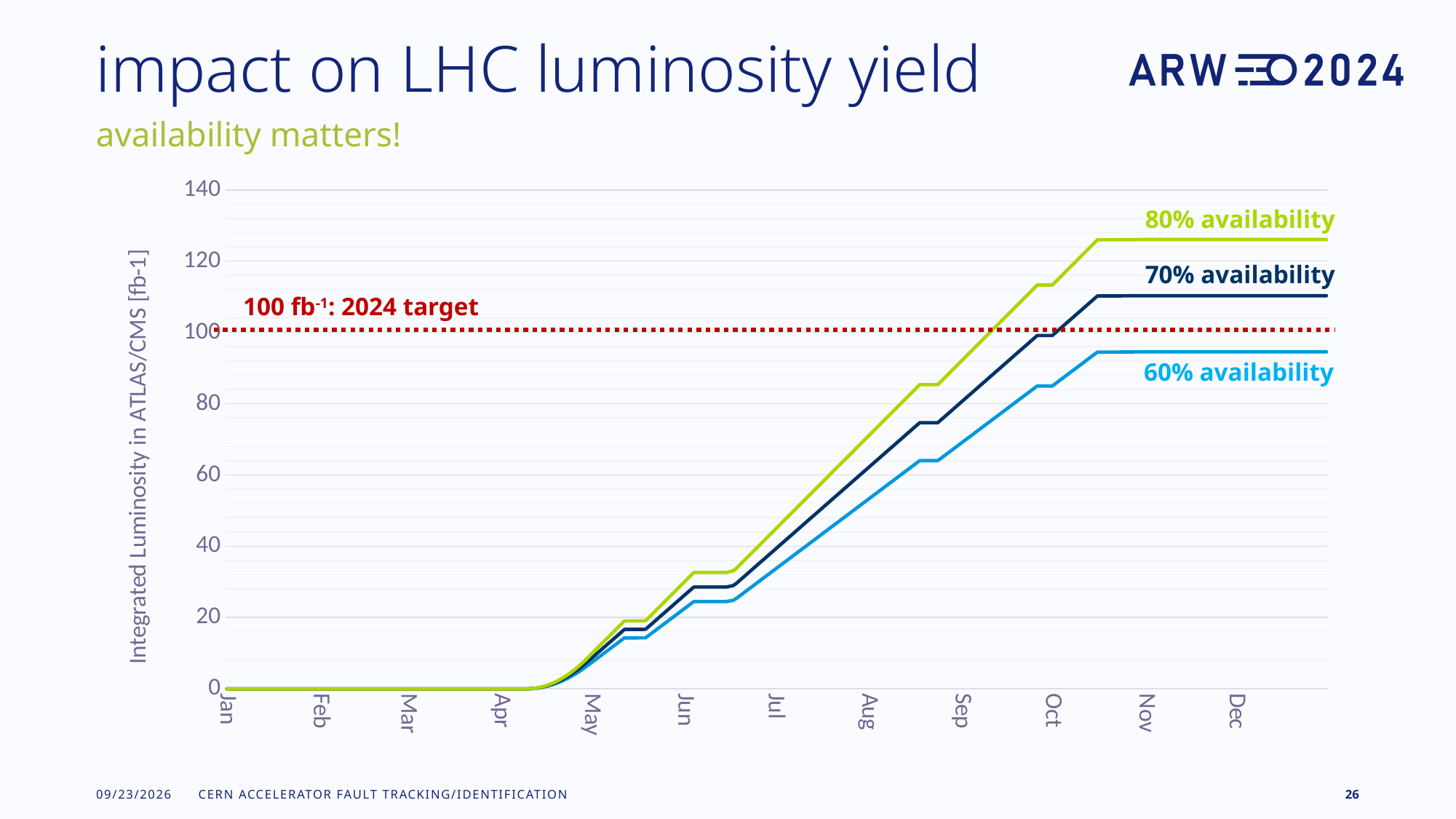
Is the final value for 70% availability greater or less than 100? greater Which availability scenario reaches the lowest integrated luminosity by the end of the year? 60% availability Is the final value for 80% availability greater or less than 120? greater At the end of the year, which is larger: the value for 70% availability or for 60% availability? 70% availability Do the integrated luminosity values rise or fall between May and October? rise Which availability scenario reaches the highest integrated luminosity by the end of the year? 80% availability What is the label of the y axis? Integrated Luminosity in ATLAS/CMS [fb-1] How many months are labelled on the x axis? 12 What is the 2024 target value marked by the dotted red line? 100 fb-1 How many availability series are plotted on the chart? 3 What kind of chart is shown on the slide? line chart Is the final value for 60% availability greater or less than 100? less